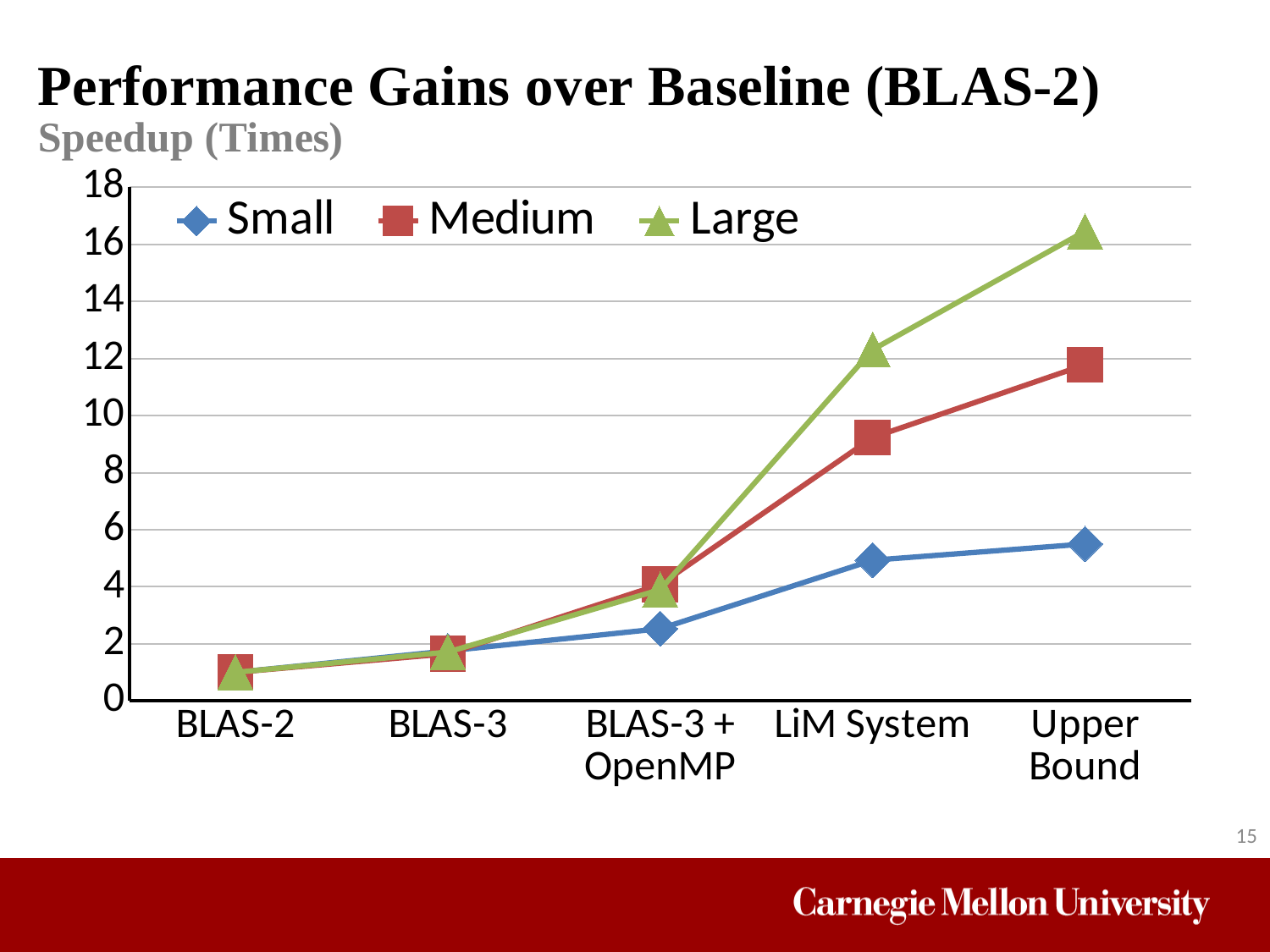
What is the label of the vertical axis? Speedup (Times) What is the title of the chart? Performance Gains over Baseline (BLAS-2) What kind of chart is shown on the slide? line chart Do the values for the Large series rise or fall from BLAS-2 to Upper Bound? rise How many categories are shown along the x axis? 5 At LiM System, which series has the larger value, Small or Large? Large Is the value for Large at Upper Bound greater or less than 16? greater Which category has the highest value for the Large series? Upper Bound Is the value for Small at Upper Bound greater or less than 6? less Which category has the lowest value for the Medium series? BLAS-2 Is the value for Medium at LiM System greater or less than 8? greater How many series does the legend list? 3